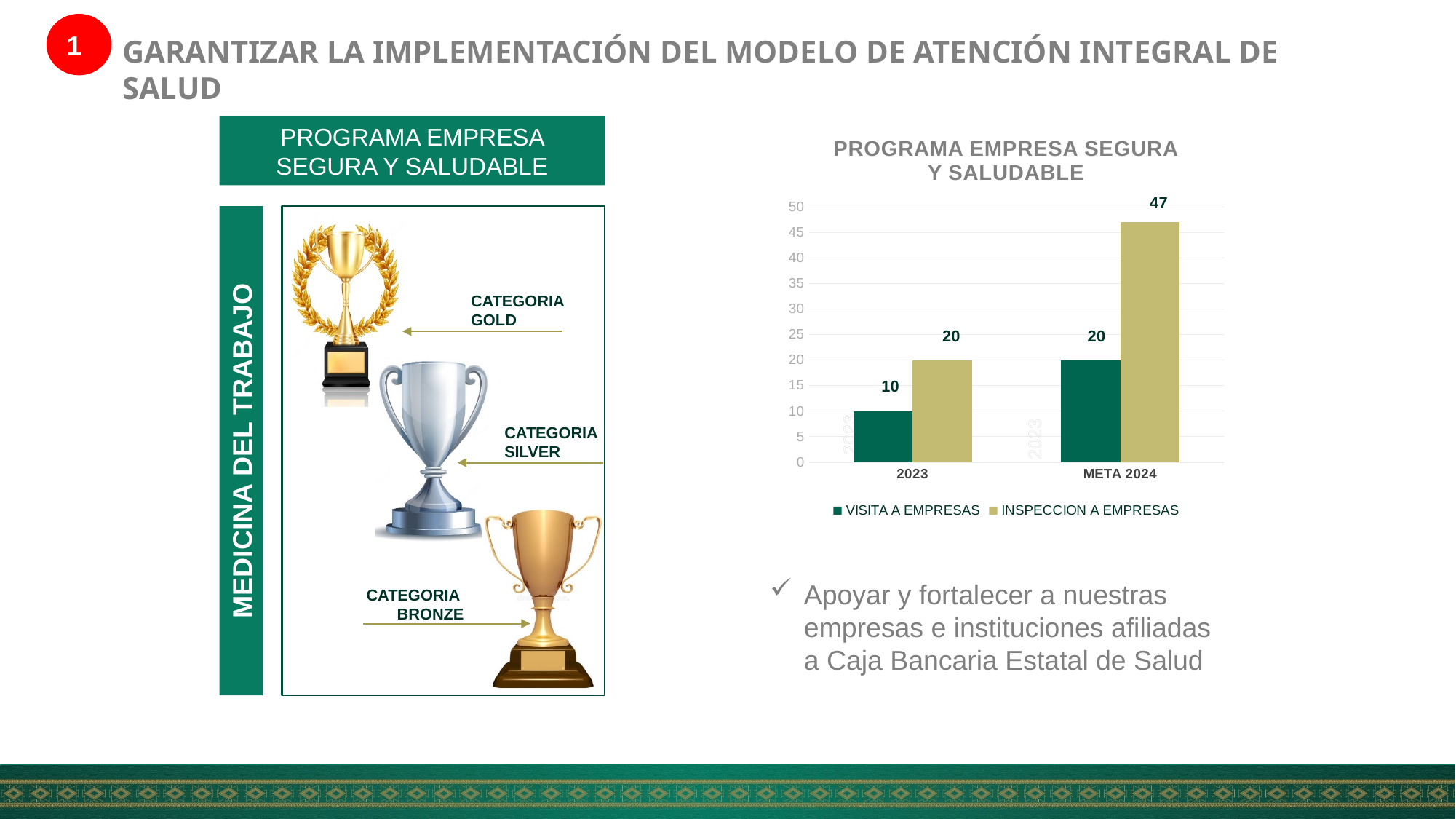
What is the value for INSPECCION A EMPRESAS in META 2024? 47 What is the title of the chart? PROGRAMA EMPRESA SEGURA Y SALUDABLE What is the value for VISITA A EMPRESAS in 2023? 10 How many categories are shown on the x axis of the chart? 2 What is the difference between INSPECCION A EMPRESAS in META 2024 and in 2023? 27 Which category has the lowest value for VISITA A EMPRESAS? 2023 What kind of chart is shown on the slide? Bar chart What is the value for INSPECCION A EMPRESAS in 2023? 20 Which is larger in META 2024: VISITA A EMPRESAS or INSPECCION A EMPRESAS? INSPECCION A EMPRESAS How many series does the chart legend list? 2 Which category has the highest value for INSPECCION A EMPRESAS? META 2024 What is the value for VISITA A EMPRESAS in META 2024? 20